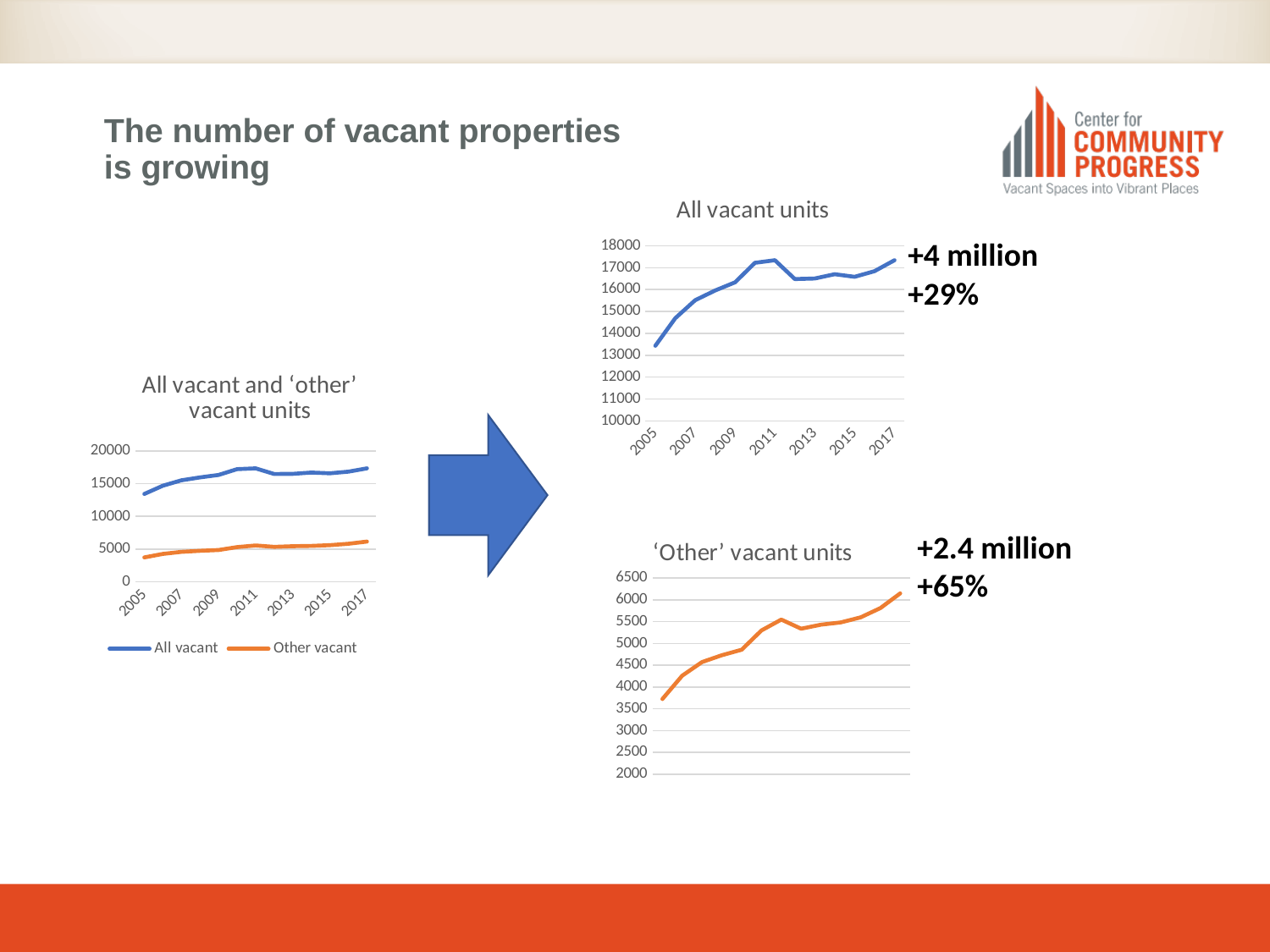
In the '‘Other’ vacant units' chart, which year has the highest value? 2017 How many series does the legend of the 'All vacant and ‘other’ vacant units' chart list? 2 In the 'All vacant and ‘other’ vacant units' chart, what are the two legend entries? All vacant, Other vacant In the '‘Other’ vacant units' chart, is the value for 2005 greater or less than 4000? less In the 'All vacant and ‘other’ vacant units' chart, which series is higher in 2017, All vacant or Other vacant? All vacant In the 'All vacant units' chart, which year has the lowest value? 2005 In the 'All vacant units' chart, is the value for 2017 greater or less than 17000? greater In the '‘Other’ vacant units' chart, do values generally rise or fall from 2005 to 2017? rise What percentage increase is annotated next to the '‘Other’ vacant units' chart? +65% What kind of chart is the 'All vacant units' chart? line chart In the 'All vacant units' chart, is the value for 2005 greater or less than 14000? less